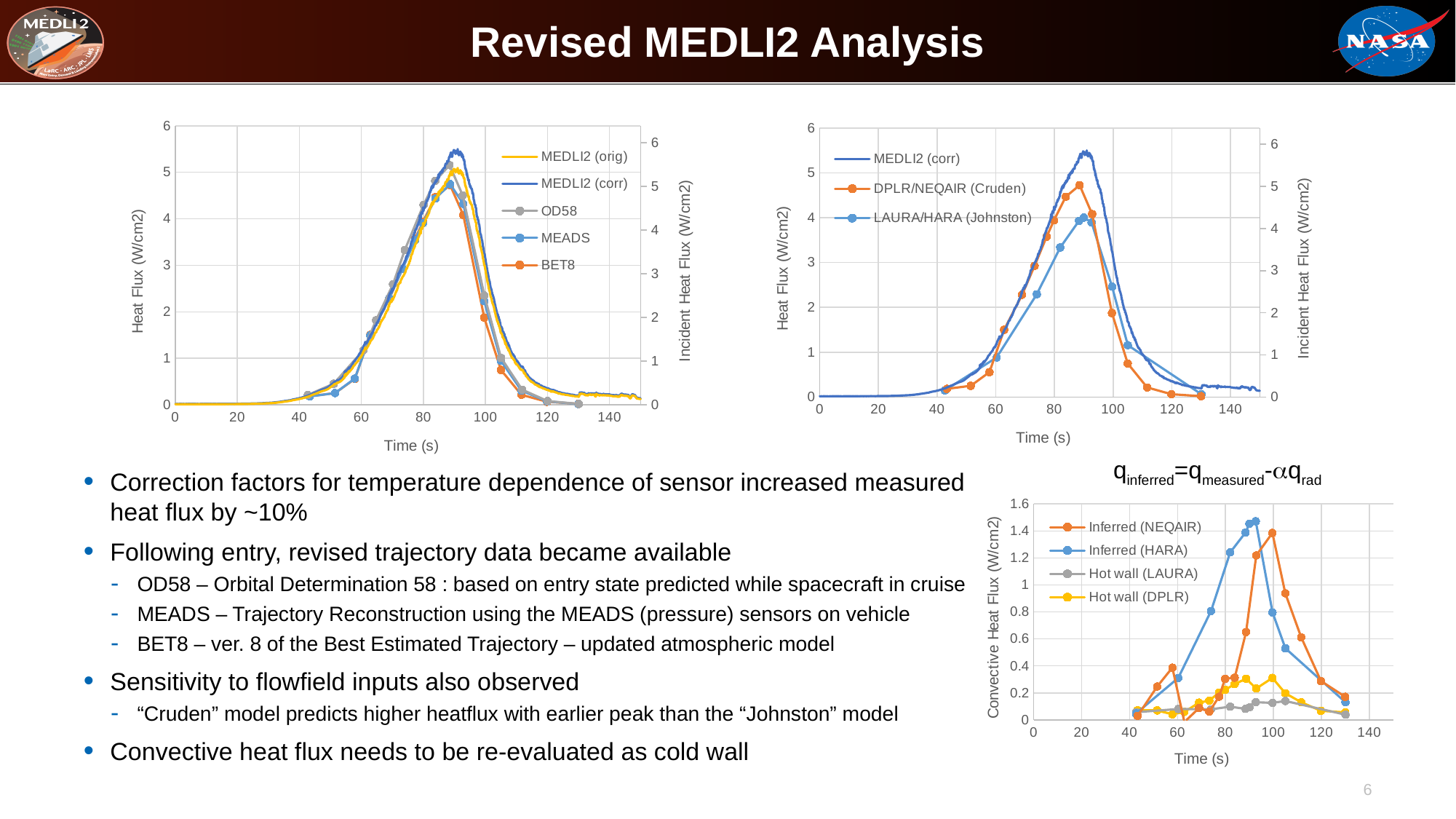
How many series does the legend of the bottom-right chart list? 4 In the top-left chart, is the peak value of the BET8 series greater or less than 5? less How many series does the legend of the top-left chart list? 5 What is the title of the vertical axis of the bottom-right chart? Convective Heat Flux (W/cm2) How many series does the legend of the top-right chart list? 3 What kind of chart is the top-left chart? line chart In the top-left chart, which series reaches the highest peak value? MEDLI2 (corr) In the top-right chart, is the peak value of the LAURA/HARA (Johnston) series greater or less than 5? less In the top-right chart, which of DPLR/NEQAIR (Cruden) and LAURA/HARA (Johnston) reaches a higher peak? DPLR/NEQAIR (Cruden) In the bottom-right chart, which series has the lowest peak value? Hot wall (LAURA) In the bottom-right chart, is the peak value of the Hot wall (DPLR) series greater or less than 0.4? less